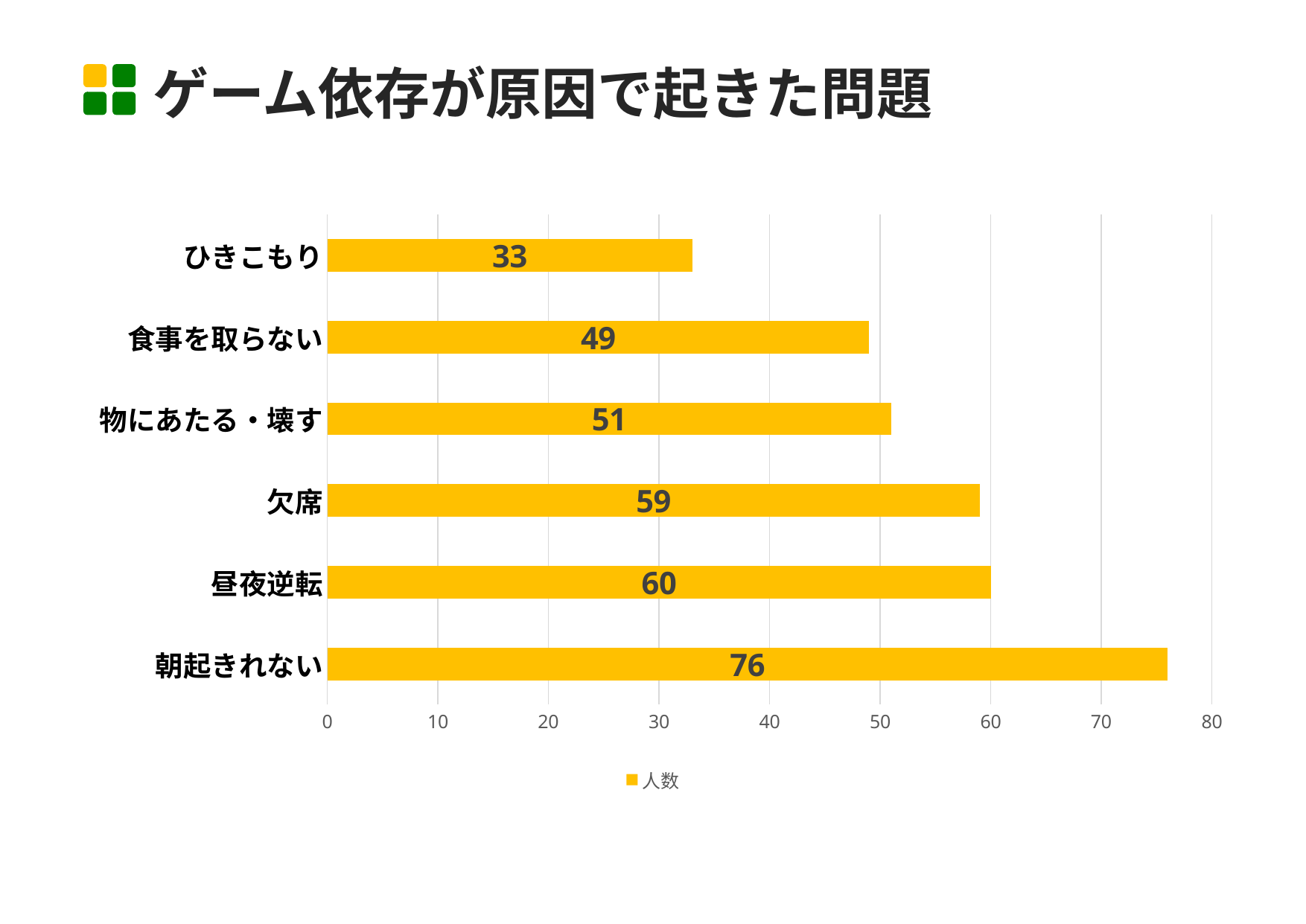
What is the difference between the values for 欠席 and ひきこもり? 26 How many series does the legend list? 1 How many categories are shown in the chart? 6 What is the value for 朝起きれない? 76 What is the value for 食事を取らない? 49 Which category has the lowest value? ひきこもり What is the value for ひきこもり? 33 What kind of chart is shown on the slide? bar chart What is the title of the slide? ゲーム依存が原因で起きた問題 What is the difference between the values for 朝起きれない and 昼夜逆転? 16 Which category has the highest value? 朝起きれない Which is larger, the value for 欠席 or the value for 食事を取らない? 欠席